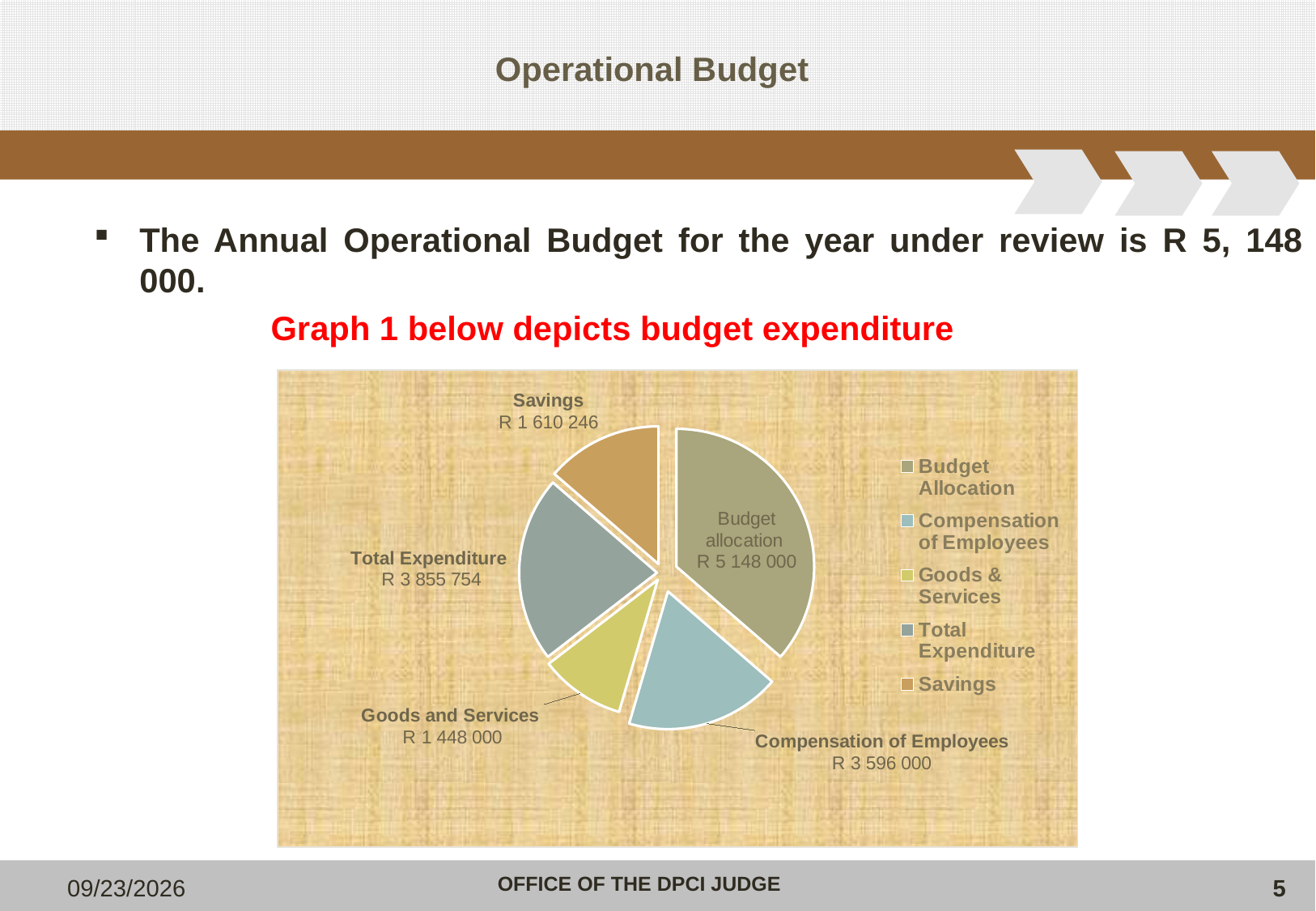
What type of chart is shown on the slide? Pie chart What value is shown for Total Expenditure in the pie chart? R 3 855 754 Which is larger in the pie chart, Total Expenditure or Compensation of Employees? Total Expenditure How many slices does the pie chart have? 5 What value is shown for Compensation of Employees in the pie chart? R 3 596 000 What is the difference between the Budget allocation value and the Total Expenditure value in the pie chart? R 1 292 246 What value is shown for the Savings slice of the pie chart? R 1 610 246 What value is shown for Budget allocation in the pie chart? R 5 148 000 What value is shown for Goods and Services in the pie chart? R 1 448 000 Which slice of the pie chart has the smallest value? Goods and Services Which slice of the pie chart has the largest value? Budget allocation What is the difference between Compensation of Employees and Goods and Services in the pie chart? R 2 148 000